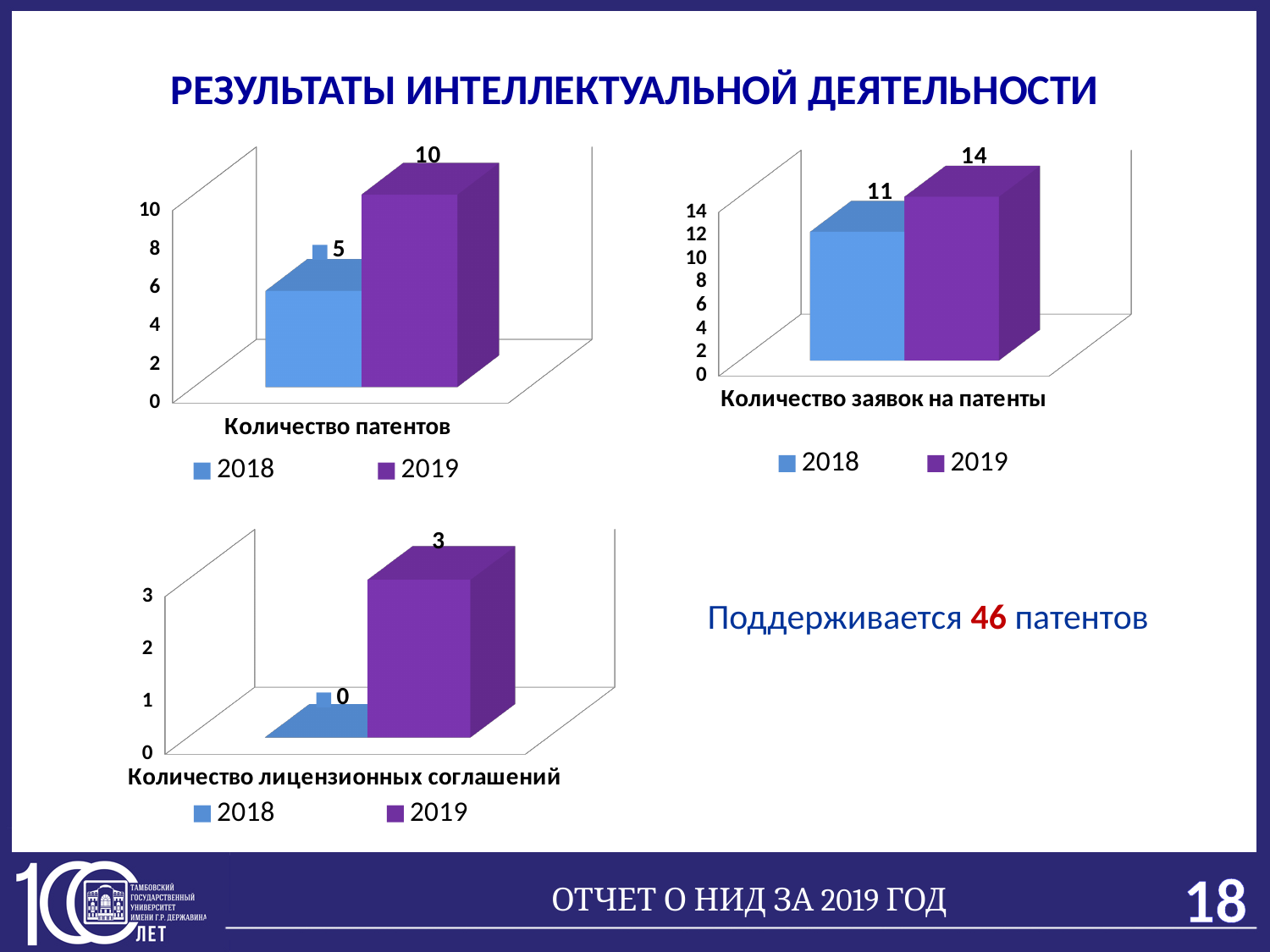
In the 'Количество патентов' chart, what is the value for 2019? 10 In the 'Количество патентов' chart, what is the value for 2018? 5 In the 'Количество заявок на патенты' chart, which year has the higher value? 2019 In the 'Количество заявок на патенты' chart, what is the difference between the 2019 and 2018 values? 3 In the 'Количество патентов' chart, what is the difference between the 2019 and 2018 values? 5 In the 'Количество лицензионных соглашений' chart, which year has the lower value? 2018 In the 'Количество лицензионных соглашений' chart, what is the value for 2018? 0 In the 'Количество лицензионных соглашений' chart, what is the value for 2019? 3 In the 'Количество заявок на патенты' chart, what is the value for 2018? 11 What kind of chart is the 'Количество заявок на патенты' chart? Bar chart How many series does the legend of the 'Количество патентов' chart list? 2 In the 'Количество заявок на патенты' chart, what is the value for 2019? 14